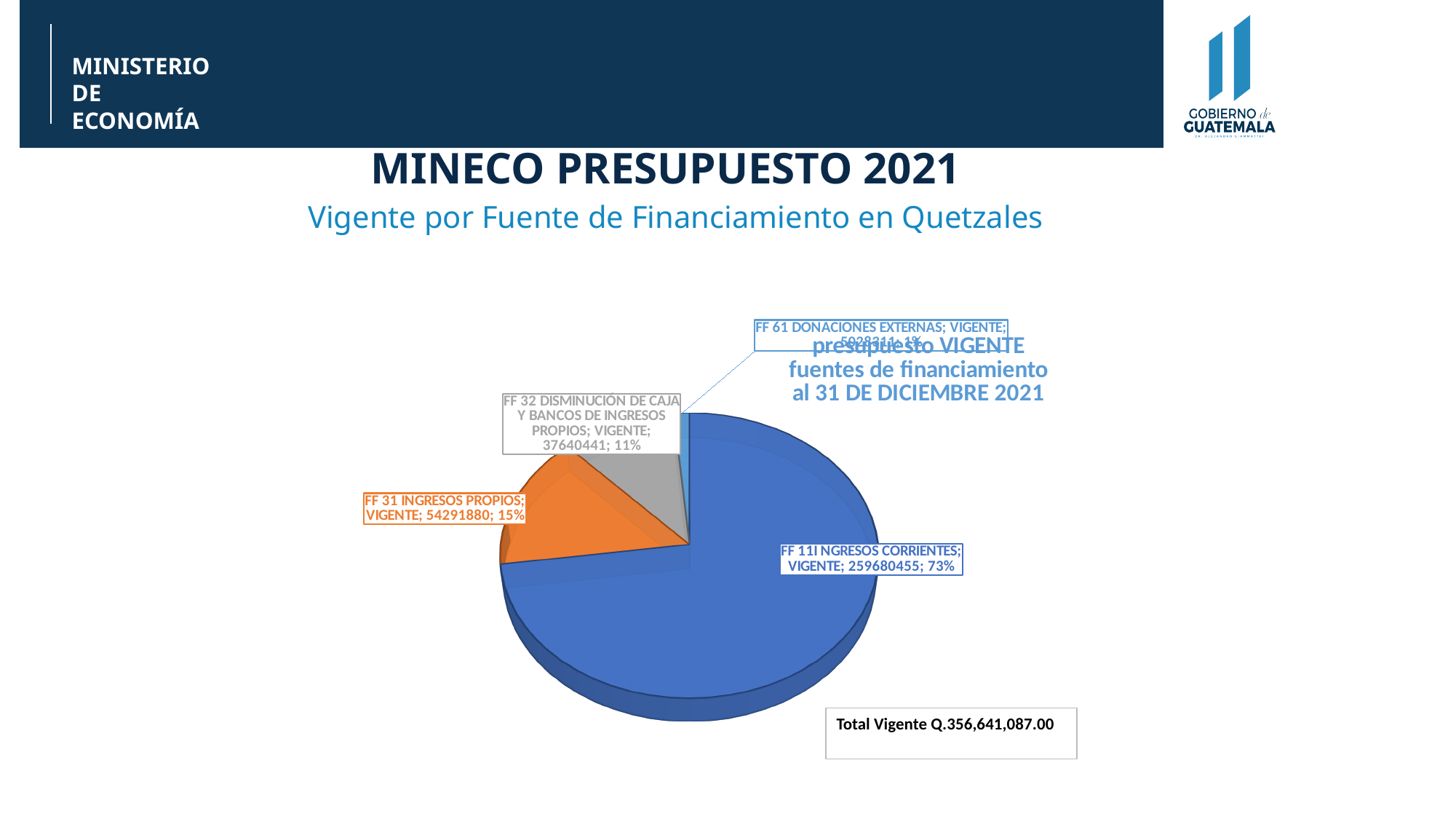
How many slices does the pie chart have? 4 What share of the pie does FF 11 INGRESOS CORRIENTES represent? 73% What is the Total Vigente shown on the slide? Q.356,641,087.00 What is the difference between the vigente values of FF 11 INGRESOS CORRIENTES and FF 31 INGRESOS PROPIOS? 205388575 Which funding source has the largest slice of the pie? FF 11 INGRESOS CORRIENTES What is the vigente value for FF 32 DISMINUCIÓN DE CAJA Y BANCOS DE INGRESOS PROPIOS? 37640441 Which funding source has the smallest slice of the pie? FF 61 DONACIONES EXTERNAS What kind of chart is shown on the slide? Pie chart What is the vigente value for FF 31 INGRESOS PROPIOS? 54291880 Which is larger, the vigente value for FF 31 INGRESOS PROPIOS or for FF 32 DISMINUCIÓN DE CAJA Y BANCOS DE INGRESOS PROPIOS? FF 31 INGRESOS PROPIOS What share of the pie does FF 31 INGRESOS PROPIOS represent? 15% What is the vigente value for FF 11 INGRESOS CORRIENTES? 259680455